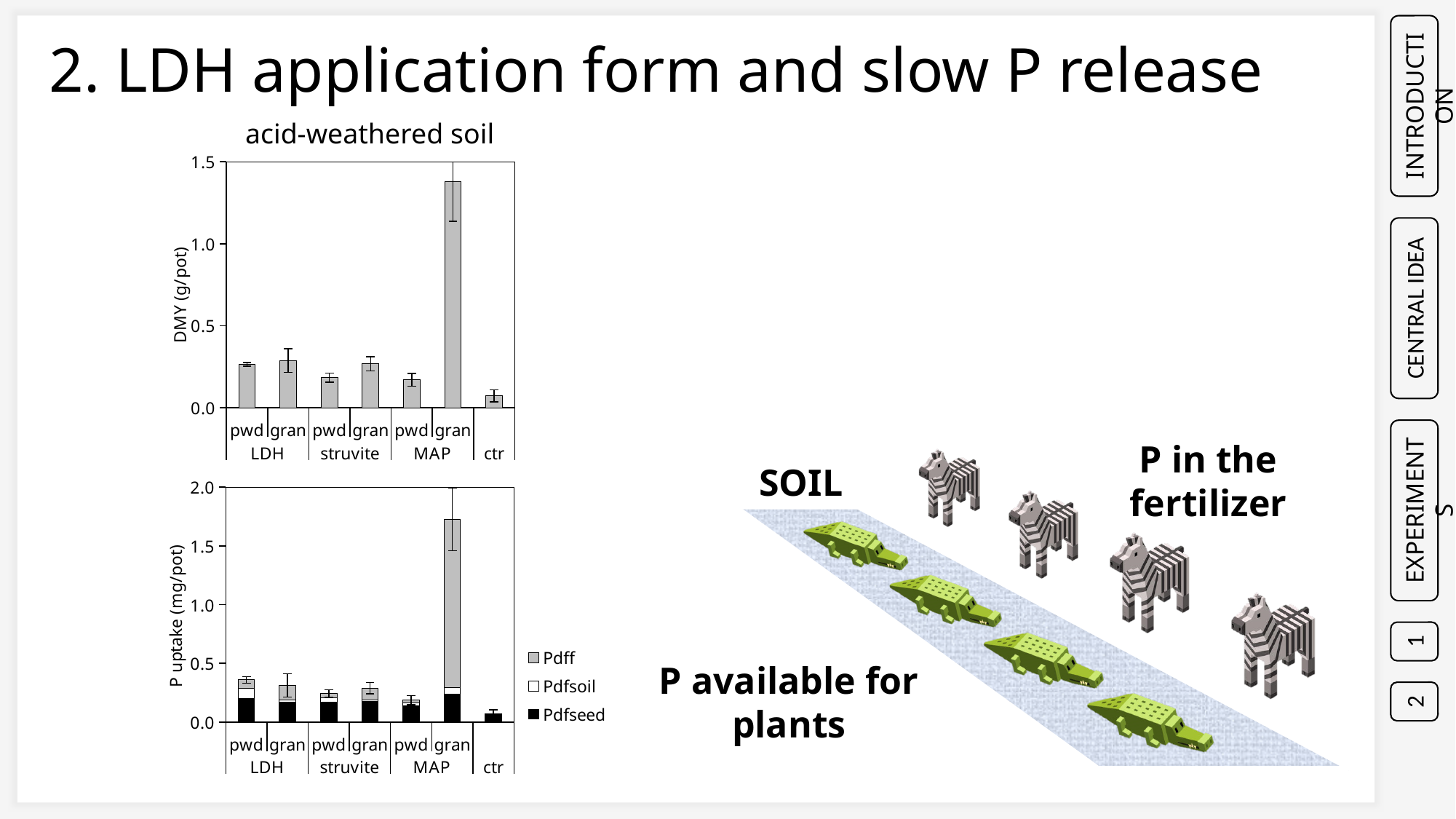
In the top chart (DMY), is the value for MAP gran greater or less than 1.0? greater In the top chart (DMY), which bar is the lowest? ctr In the bottom chart (P uptake), is the total for MAP gran greater or less than 1.5? greater In the top chart (DMY), which is larger, the bar for MAP gran or the bar for MAP pwd? MAP gran In the bottom chart (P uptake), which stacked bar has the greatest total? MAP gran Which legend entry in the bottom chart is shown in black? Pdfseed What is the y-axis label of the bottom chart? P uptake (mg/pot) What kind of chart is the top chart titled 'acid-weathered soil'? bar chart In the top chart (DMY), which bar is the highest? MAP gran In the top chart (DMY), is the value for LDH pwd greater or less than 0.5? less How many series does the legend of the bottom chart (P uptake) list? 3 How many bars are plotted in the top chart (DMY)? 7